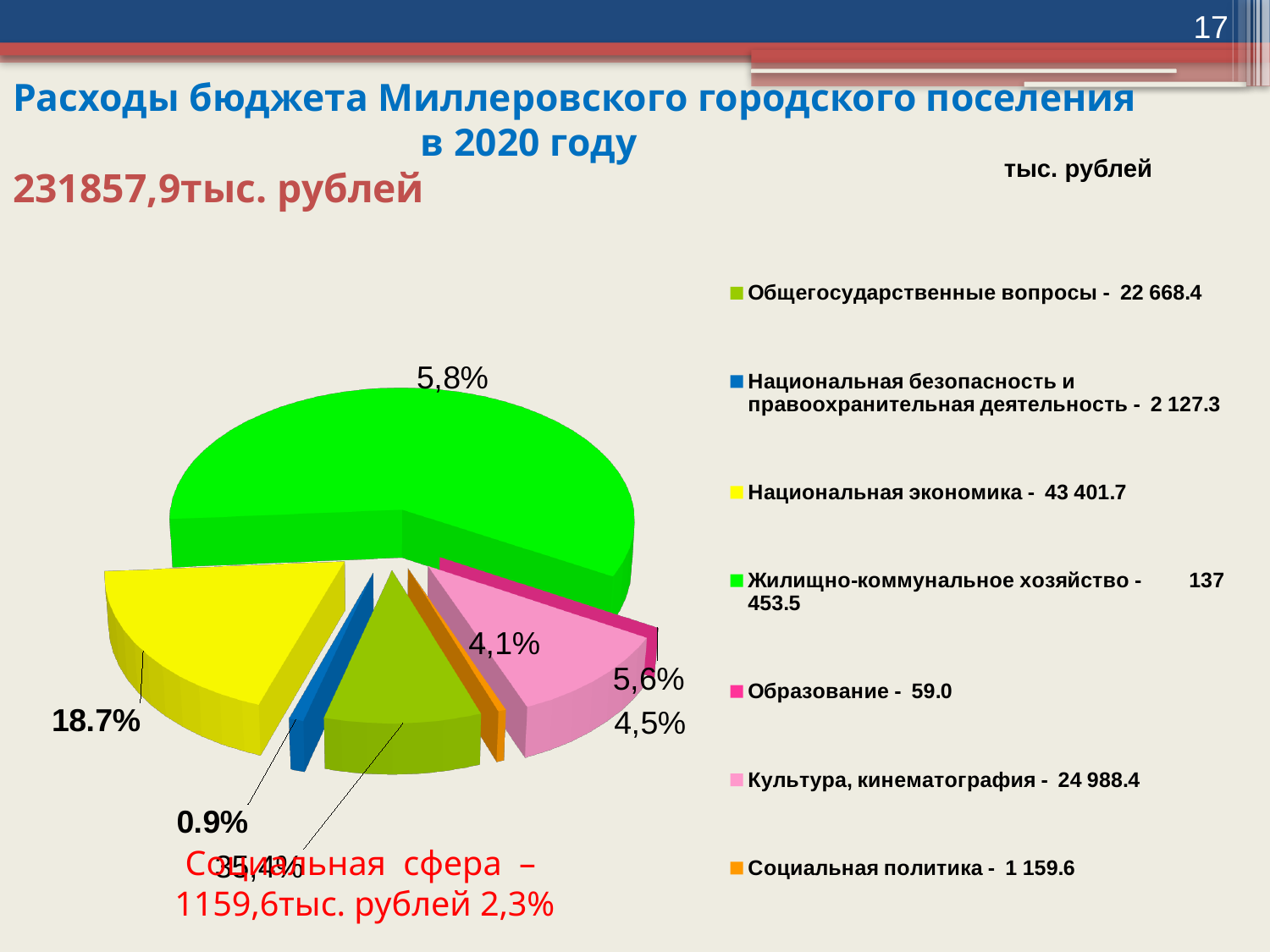
Which category has the largest value in the pie chart? Жилищно-коммунальное хозяйство What is the value for Жилищно-коммунальное хозяйство in the legend? 137 453.5 What kind of chart is shown on the slide? pie chart What is the value for Национальная экономика in the legend? 43 401.7 Which is larger, Национальная экономика or Культура, кинематография? Национальная экономика What total budget expenditure is stated on the slide for 2020? 231857,9тыс. рублей How many categories does the legend of the pie chart list? 7 What is the difference between the values for Национальная экономика and Общегосударственные вопросы? 20 733.3 What is the value for Образование in the legend? 59.0 Which category has the smallest value in the pie chart? Образование What is the value for Социальная политика in the legend? 1 159.6 What is the value for Культура, кинематография in the legend? 24 988.4